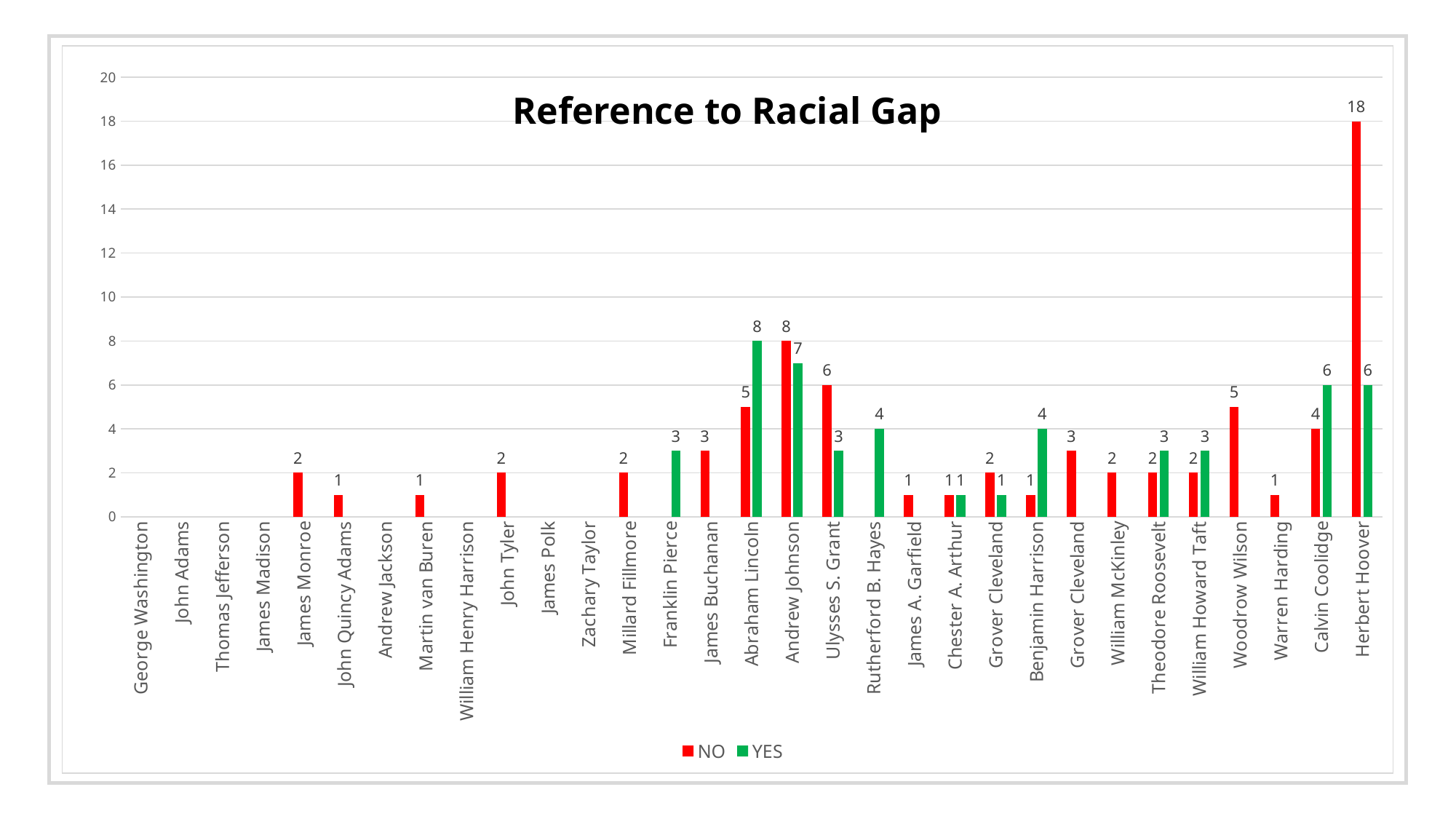
What is the YES value for Rutherford B. Hayes? 4 What is the NO value for Herbert Hoover? 18 How many series does the legend list? 2 For Calvin Coolidge, which is larger, the NO value or the YES value? YES What is the NO value for Woodrow Wilson? 5 For Andrew Johnson, which is larger, the NO value or the YES value? NO What is the title of the chart? Reference to Racial Gap What is the difference between the NO and YES values for Herbert Hoover? 12 What kind of chart is shown on the slide? Bar chart What colour represents the YES series? Green Which president has the highest NO value? Herbert Hoover What is the YES value for Abraham Lincoln? 8